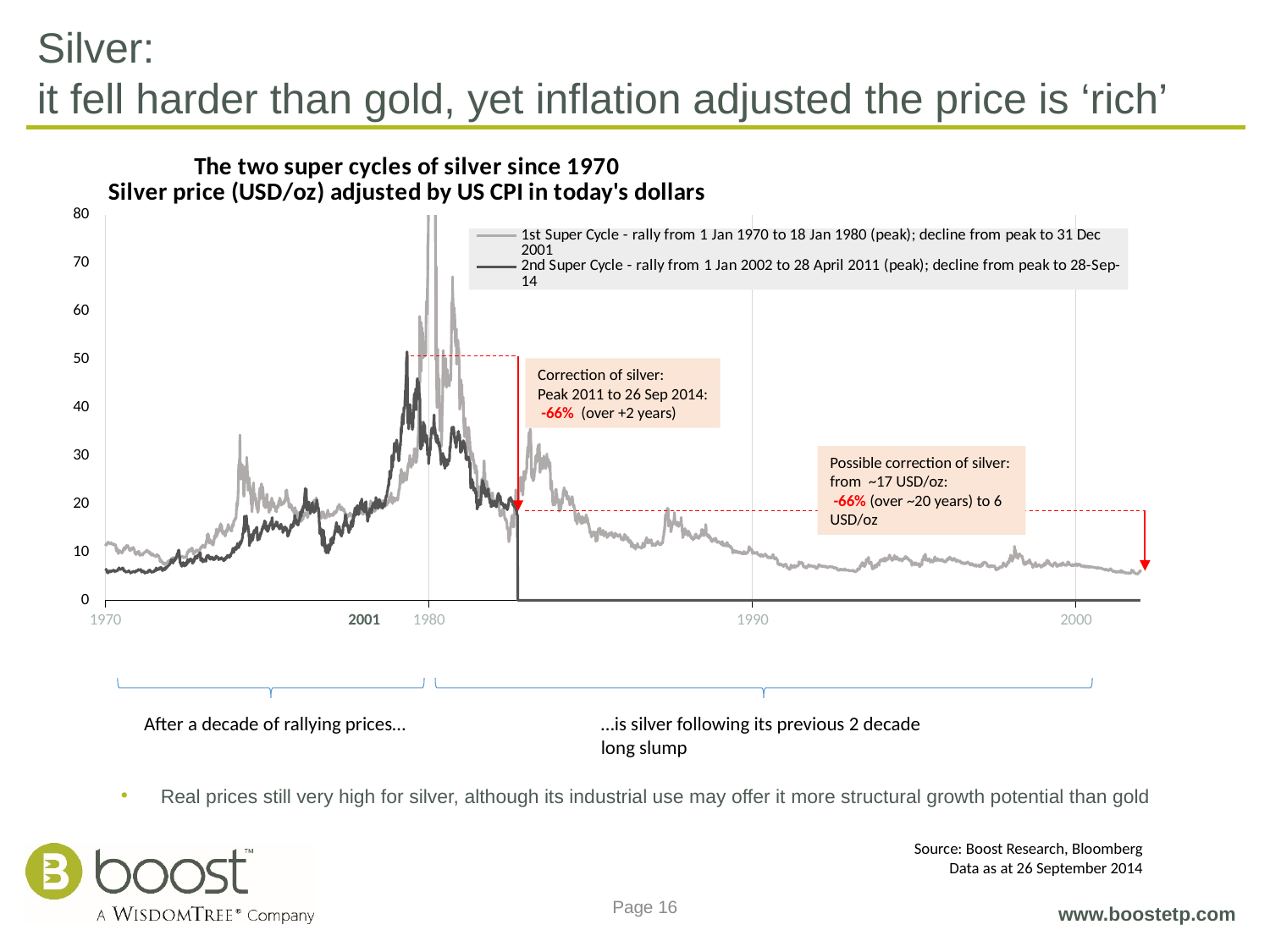
Does the 1st Super Cycle line rise or fall between the 1980 tick and the 2000 tick? Fall What kind of chart is shown on the slide? Line chart What is the highest value shown on the chart's vertical axis? 80 According to the annotation, to what price could silver fall in the possible correction from ~17 USD/oz? 6 USD/oz What is the title of the chart? The two super cycles of silver since 1970 Silver price (USD/oz) adjusted by US CPI in today's dollars Does the 2nd Super Cycle line rise or fall from its start at the left of the chart to its peak? Rise Is the value of the 1st Super Cycle line at the 2000 tick greater or less than 10? less How many series does the chart's legend list? 2 Is the peak value of the 2nd Super Cycle line greater or less than 40? greater Is the peak value of the 1st Super Cycle line around 1980 greater or less than 70? greater According to the annotation, what was the correction of silver from its 2011 peak to 26 Sep 2014? -66% Which series reaches the higher peak on the chart, the 1st Super Cycle or the 2nd Super Cycle? 1st Super Cycle